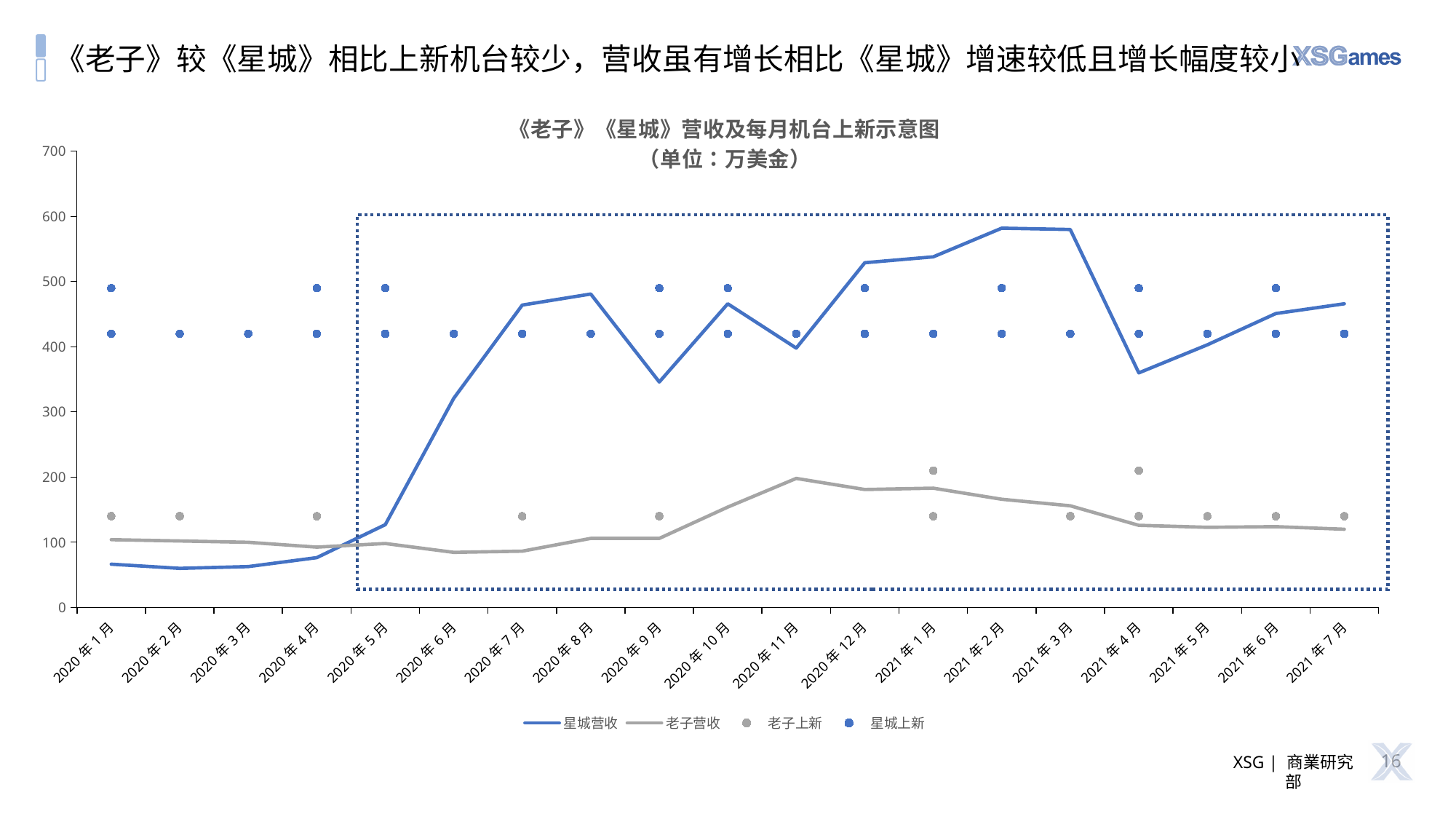
Is the value of 星城营收 in 2020年12月 greater or less than 500? greater In which month does 老子营收 reach its highest value? 2020年11月 Does 星城营收 rise or fall from 2020年4月 to 2020年8月? rise What kind of chart is shown on the slide? line chart Is the value of 星城营收 in 2020年9月 greater or less than 400? less How many series does the legend list? 4 Is the value of 老子营收 in 2020年11月 greater or less than 150? greater In 2020年1月, which is larger: 星城营收 or 老子营收? 老子营收 In 2020年7月, which is larger: 星城营收 or 老子营收? 星城营收 What is the unit stated in the chart title? 万美金 How many months are shown along the x axis? 19